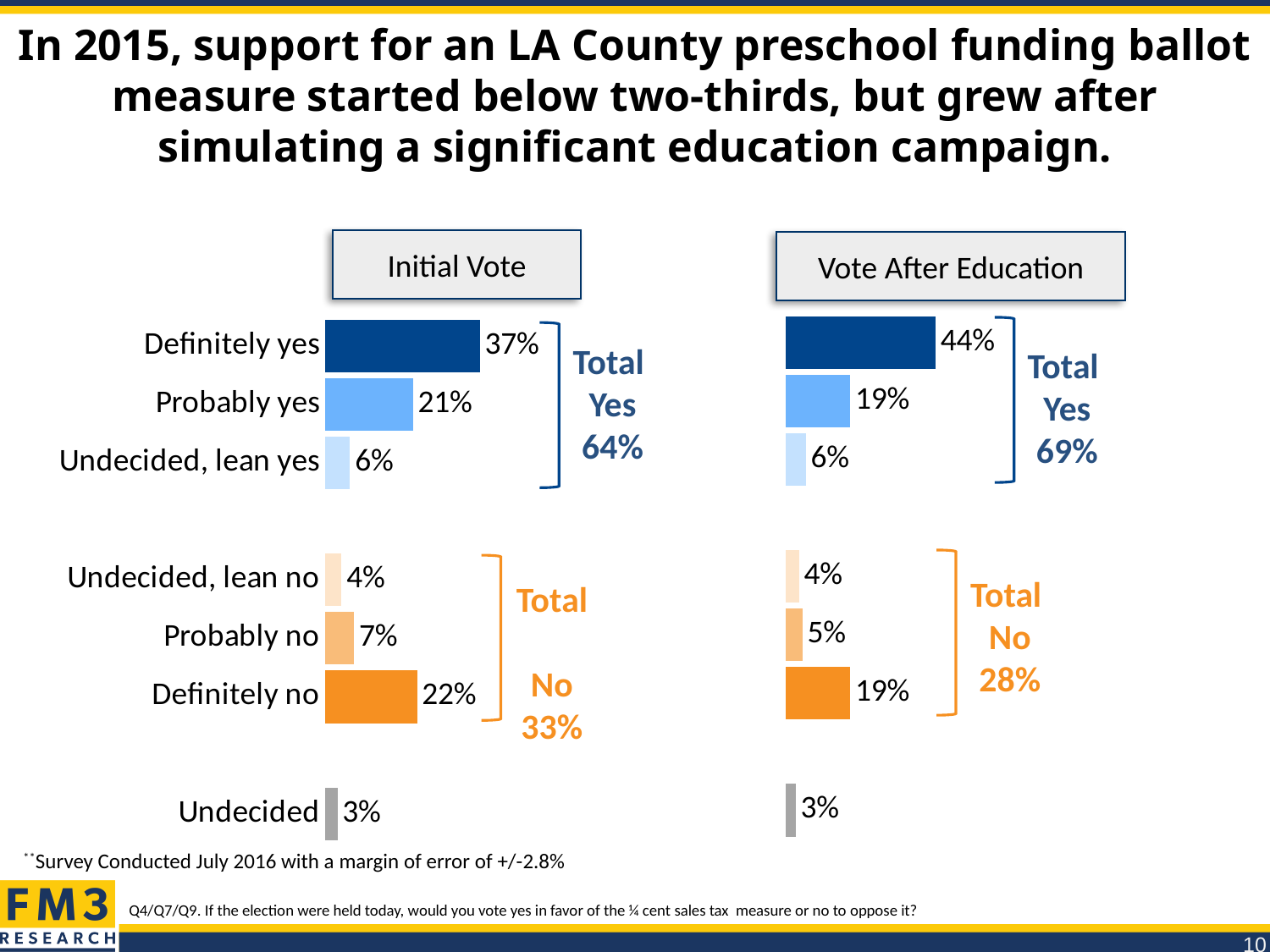
What is the difference between the "Definitely yes" values in the Vote After Education chart and the Initial Vote chart? 7% In the Initial Vote chart, which category has the highest value? Definitely yes In the Vote After Education chart, what percentage said "Definitely yes"? 44% What is the Total Yes shown for the Vote After Education chart? 69% In the Vote After Education chart, which is larger: "Probably yes" or "Definitely no"? They are equal (19%) In the Initial Vote chart, which category has the lowest value? Undecided In the Initial Vote chart, what percentage said "Definitely no"? 22% In the Initial Vote chart, which is larger: "Probably yes" or "Definitely no"? Definitely no In the Initial Vote chart, what percentage said "Definitely yes"? 37% What kind of chart is the Initial Vote chart? Bar chart In the Vote After Education chart, what percentage said "Probably no"? 5% How many categories are shown in the Initial Vote chart? 7